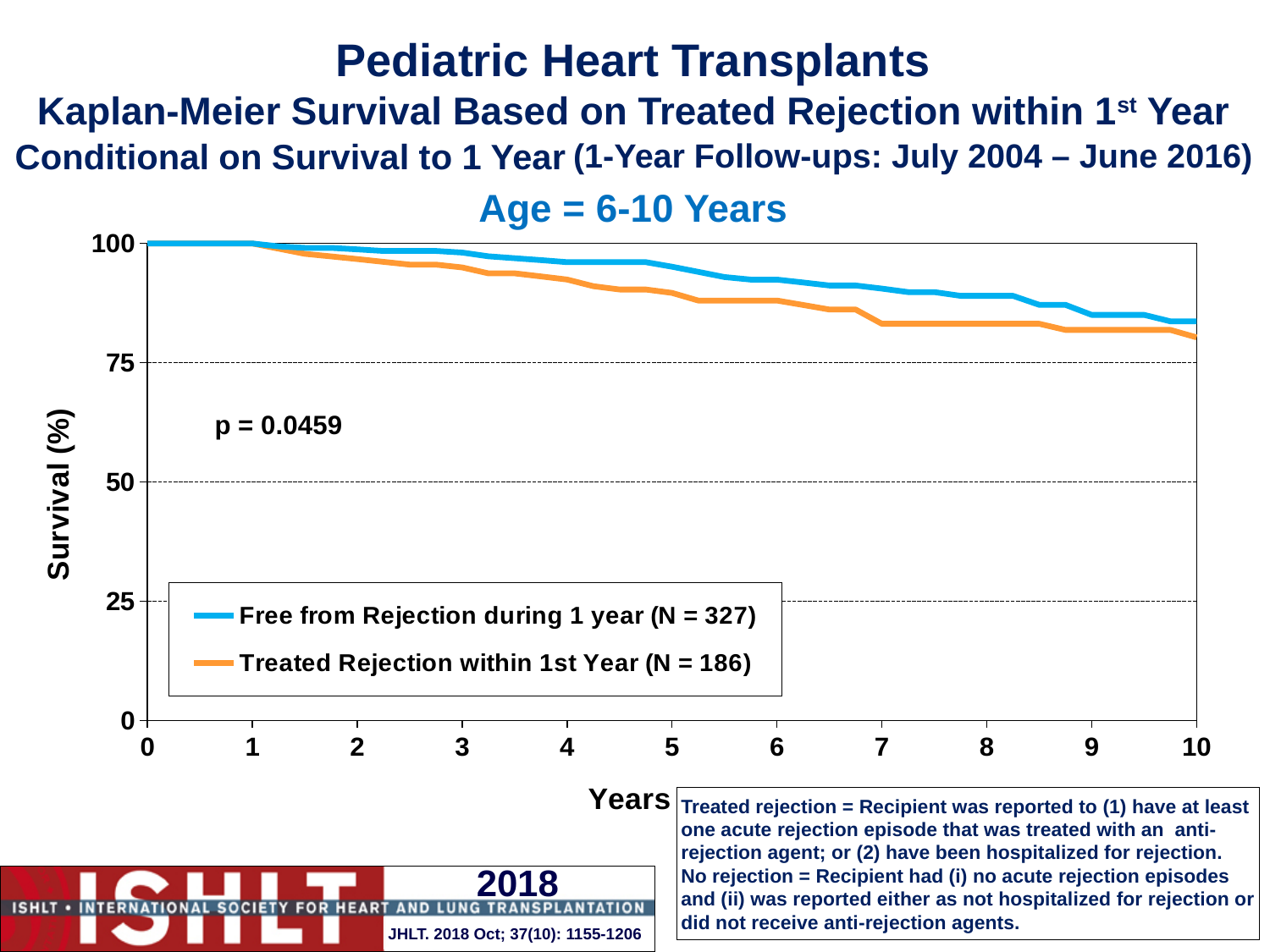
Is the survival value for the Treated Rejection within 1st Year group at year 5 greater or less than 75? greater Is the survival value for the Free from Rejection during 1 year group at year 10 greater or less than 75? greater Is the survival value for the Treated Rejection within 1st Year group at year 10 greater or less than 75? greater What is the p-value shown on the chart? p = 0.0459 What is the N for the Treated Rejection within 1st Year group in the legend? 186 How many series does the legend list? 2 What is the survival value for the Free from Rejection during 1 year group at year 0? 100 Do the survival curves rise or fall as years increase? fall At year 10, which group has the higher survival: Free from Rejection during 1 year or Treated Rejection within 1st Year? Free from Rejection during 1 year What kind of chart is shown on the slide? line chart What is the maximum value shown on the y axis? 100 What is the survival value for the Treated Rejection within 1st Year group at year 0? 100